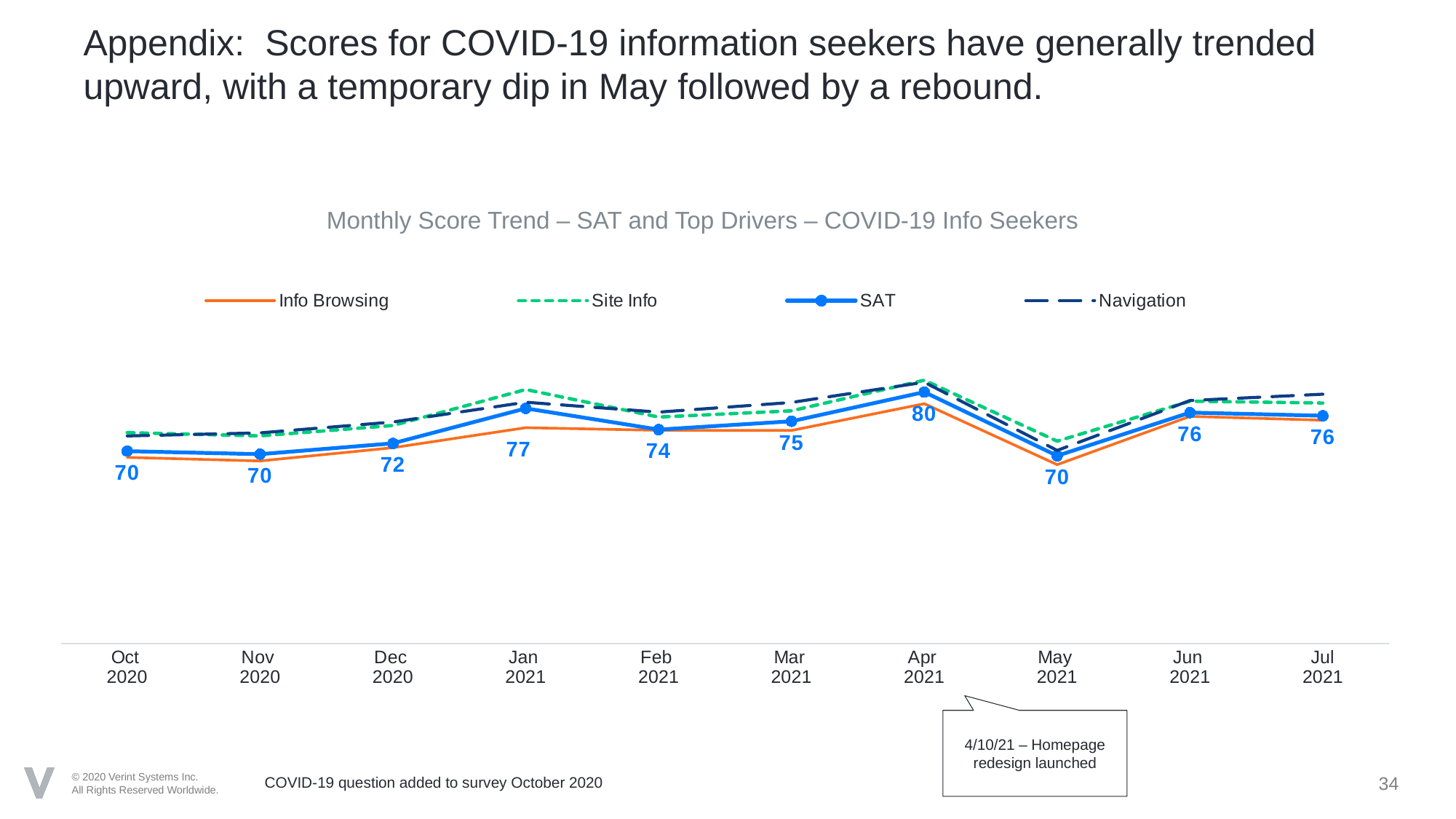
Which is larger, the SAT score in Mar 2021 or in Jun 2021? Jun 2021 In which month does the SAT series reach its highest value? Apr 2021 What is the difference between the SAT score in Apr 2021 and May 2021? 10 What is the SAT score for Jan 2021? 77 What is the SAT score for Apr 2021? 80 What is the SAT score for Jul 2021? 76 What is the difference between the SAT score in Jan 2021 and Feb 2021? 3 What kind of chart is shown on the slide? Line chart How many series does the legend list? 4 How many months are shown on the x axis? 10 Does the SAT series rise or fall from May 2021 to Jun 2021? Rise What is the SAT score for May 2021? 70